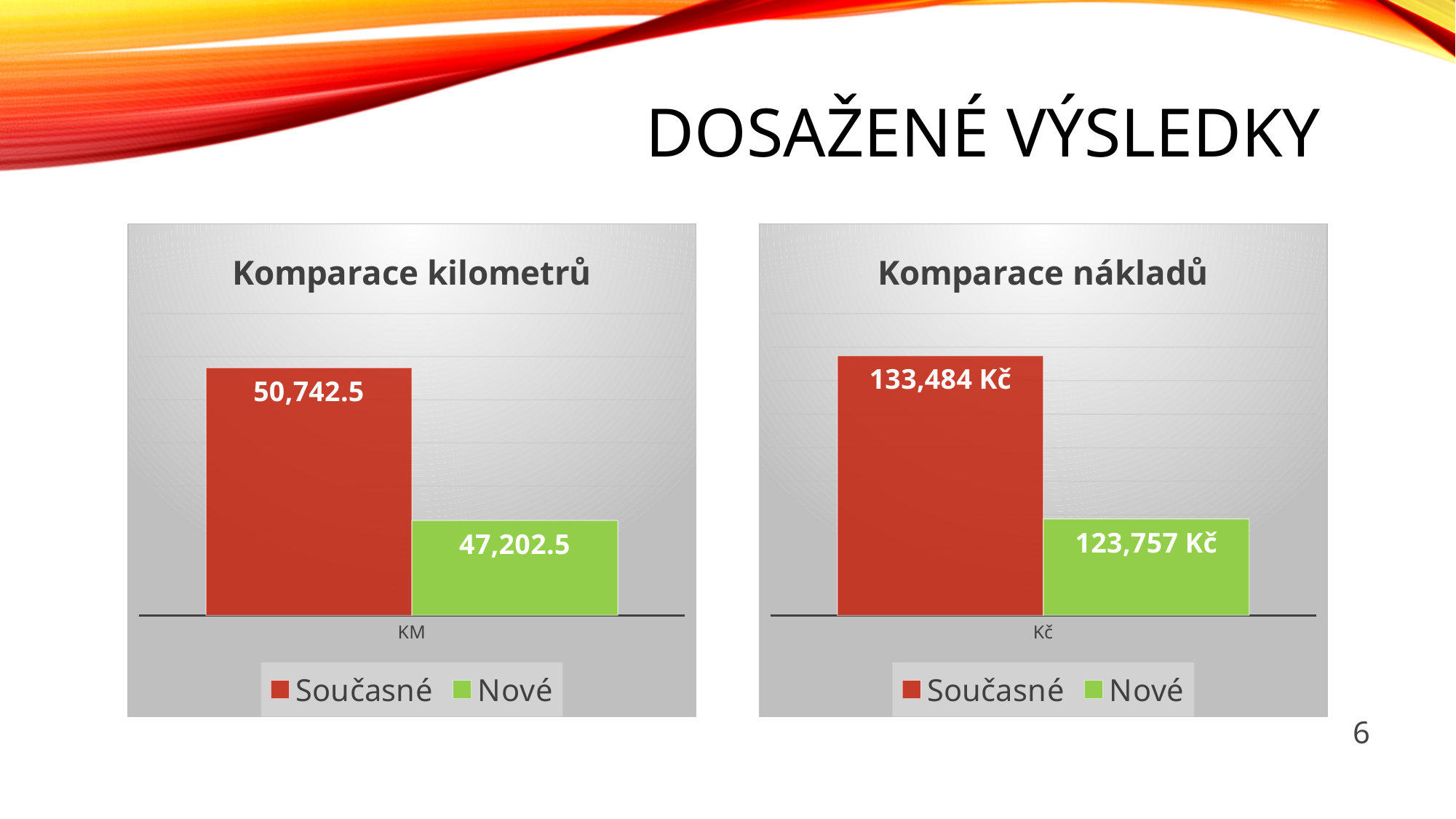
In the chart titled "Komparace nákladů", what is the value for Nové? 123,757 Kč In the chart titled "Komparace kilometrů", what is the difference between the Současné and Nové values? 3,540 In the chart titled "Komparace nákladů", what is the difference between the Současné and Nové values? 9,727 Kč In the chart titled "Komparace kilometrů", which series has the higher value? Současné In the chart titled "Komparace kilometrů", what colour is the bar for Nové? green In the chart titled "Komparace kilometrů", what is the value for Nové? 47,202.5 How many series does the legend of the chart titled "Komparace kilometrů" list? 2 What kind of chart is the chart titled "Komparace nákladů"? bar chart In the chart titled "Komparace nákladů", what is the value for Současné? 133,484 Kč In the chart titled "Komparace kilometrů", what is the value for Současné? 50,742.5 In the chart titled "Komparace nákladů", is the value for Současné larger or smaller than the value for Nové? larger In the chart titled "Komparace nákladů", which series has the lower value? Nové